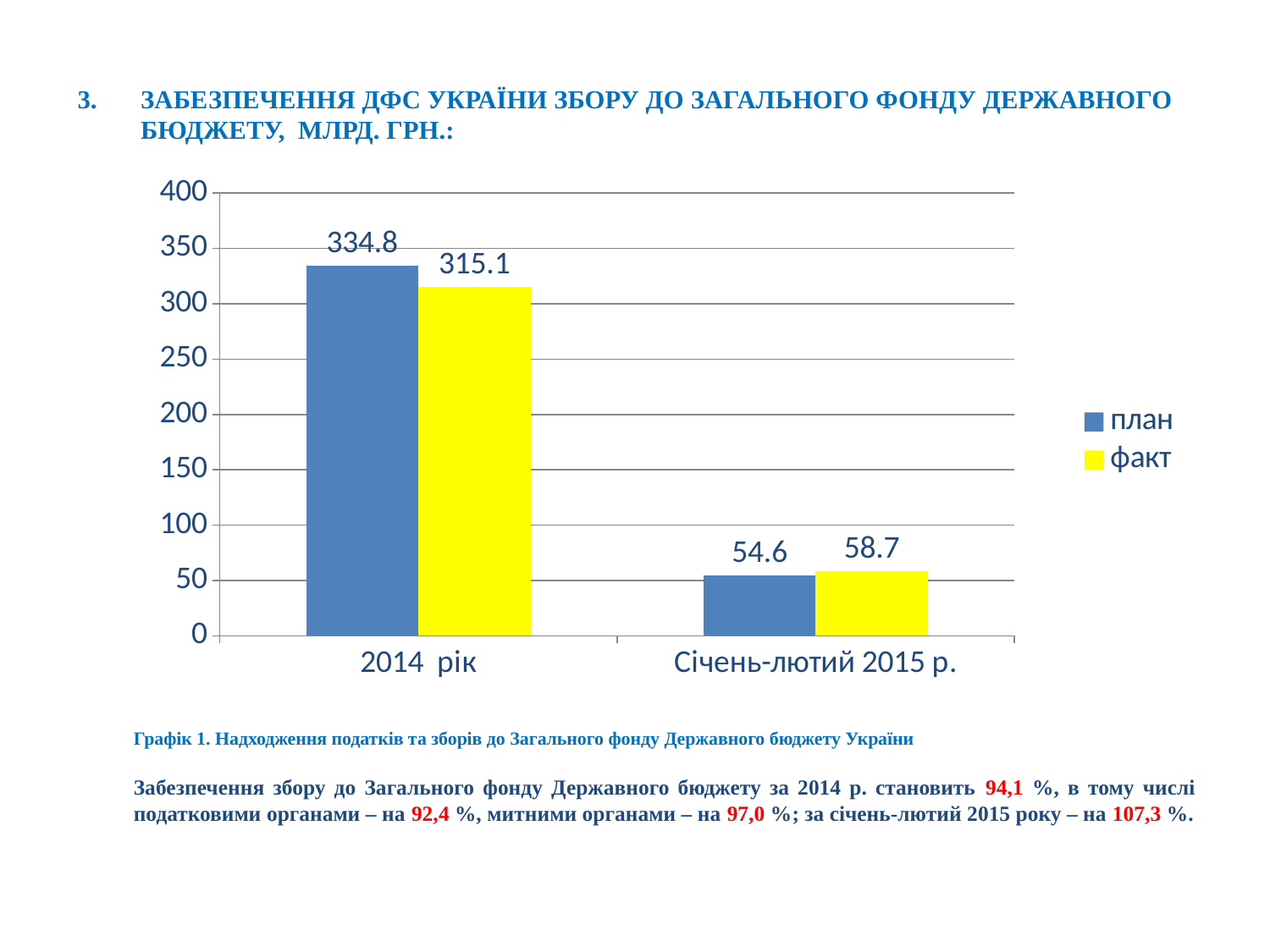
How many categories are shown on the x axis? 2 What kind of chart is shown on the slide? bar chart What is the факт value for Січень-лютий 2015 р.? 58.7 How many series does the legend list? 2 Which category has the lowest факт value? Січень-лютий 2015 р. What is the план value for Січень-лютий 2015 р.? 54.6 For Січень-лютий 2015 р., which is larger: план or факт? факт What is the difference between факт and план for Січень-лютий 2015 р.? 4.1 What is the план value for 2014 рік? 334.8 Which category has the highest план value? 2014 рік What is the факт value for 2014 рік? 315.1 What is the difference between план and факт for 2014 рік? 19.7